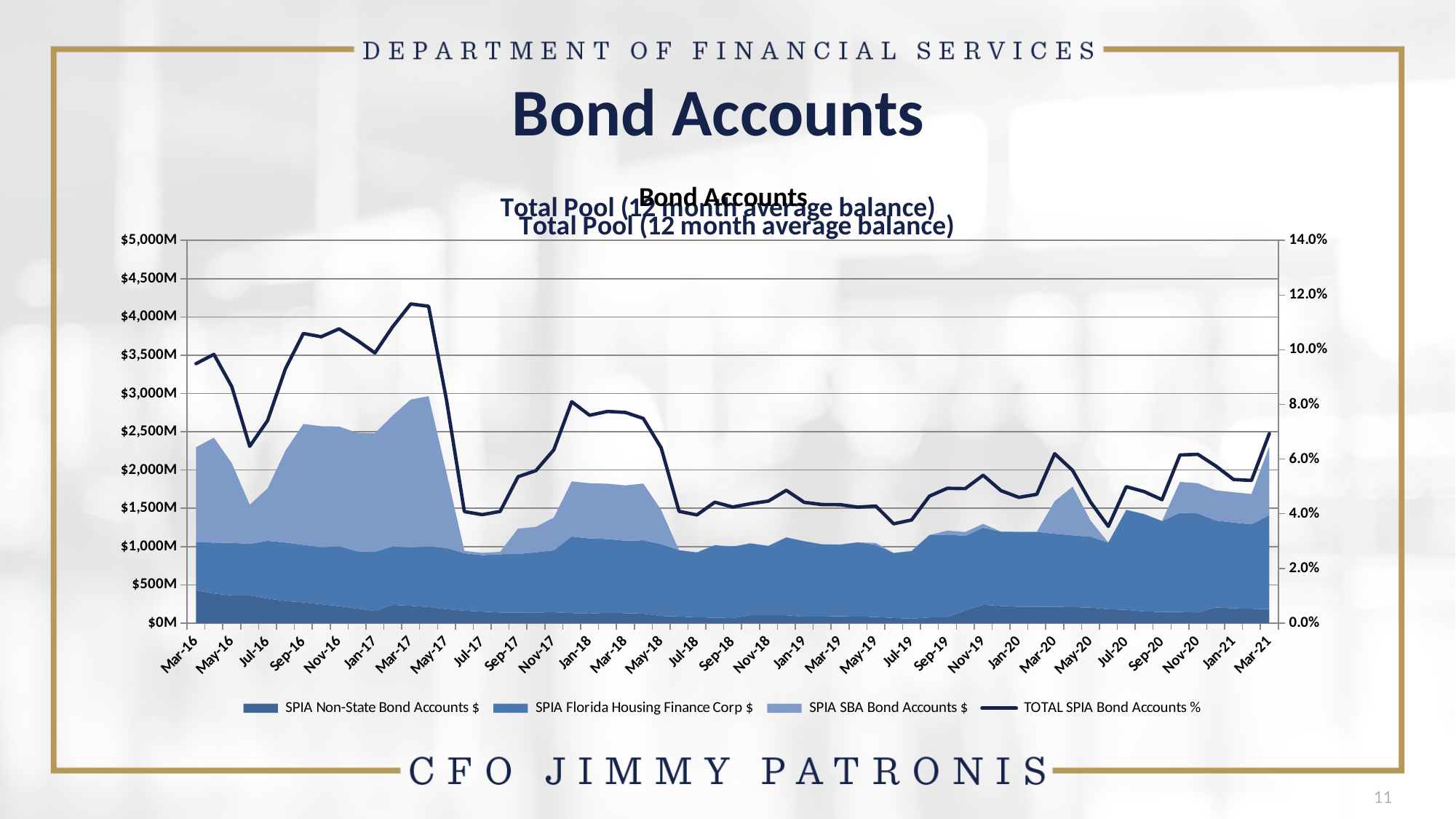
Which is larger, the TOTAL SPIA Bond Accounts % at Mar-16 or at Mar-21? Mar-16 What is the highest value shown on the left vertical axis? $5,000M How many series does the chart legend list? 4 What is the first month label on the x axis? Mar-16 Which series in the legend is plotted as a line rather than a shaded area? TOTAL SPIA Bond Accounts % Is the total stacked balance at Mar-21 greater or less than $2,000M? greater Is the total stacked balance at Mar-17 greater or less than $2,500M? greater Does the TOTAL SPIA Bond Accounts % line rise or fall between Mar-17 and Jul-17? fall Is the TOTAL SPIA Bond Accounts % value at Jul-17 greater or less than 6.0%? less What kind of chart is shown on the slide? Stacked area chart with a line